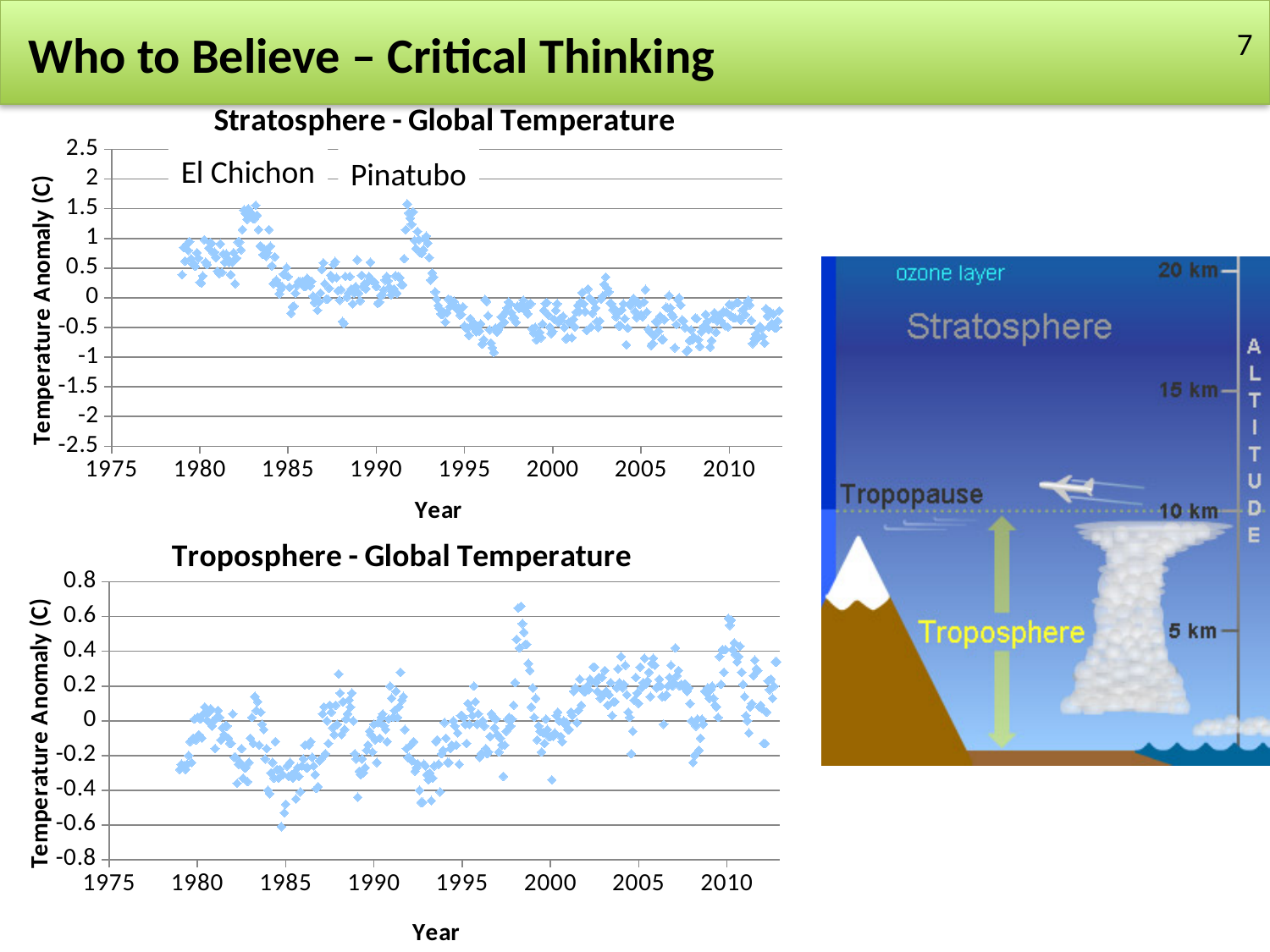
On the Stratosphere - Global Temperature chart, are the values around 2010 greater or less than 0? less What is the y-axis label on the Troposphere - Global Temperature chart? Temperature Anomaly (C) On the Stratosphere - Global Temperature chart, do the temperature anomaly values generally rise or fall from 1980 to 2010? fall What kind of chart is the Stratosphere - Global Temperature chart? scatter chart On the Stratosphere - Global Temperature chart, are the values around 1980 greater or less than 0? greater On the Troposphere - Global Temperature chart, is the highest plotted value greater or less than 0.4? greater On the Troposphere - Global Temperature chart, do the temperature anomaly values generally rise or fall from 1980 to 2010? rise What kind of chart is the Troposphere - Global Temperature chart? scatter chart Which two volcanic eruptions are labelled on the Stratosphere - Global Temperature chart? El Chichon and Pinatubo